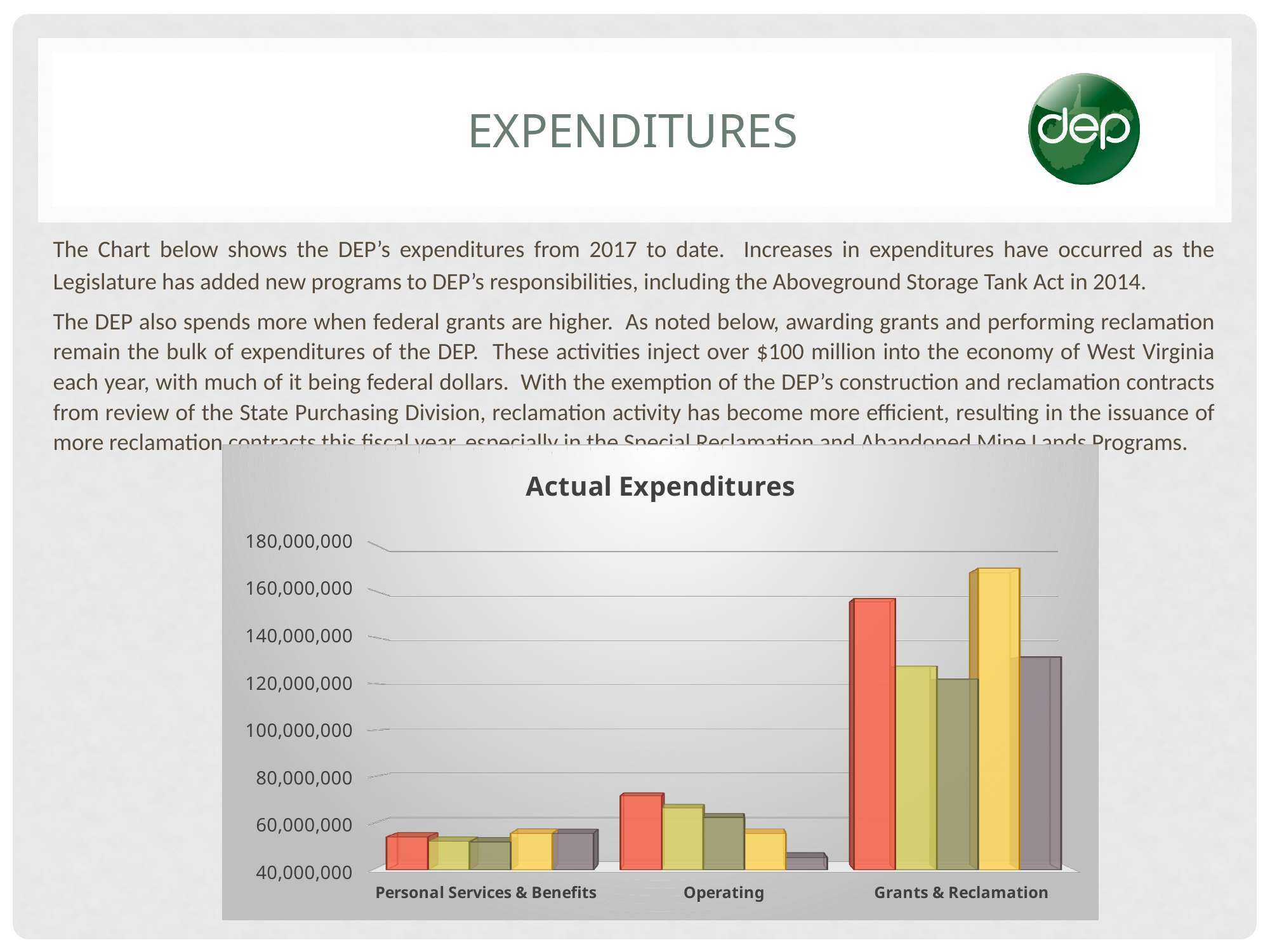
Which category has the highest expenditures in the chart? Grants & Reclamation Which category has the lowest expenditures in the chart? Personal Services & Benefits Is the value of the gray bar for Operating greater or less than 60,000,000? less For Grants & Reclamation, which is larger: the red bar or the yellow bar? the yellow bar Is the value of the tallest bar for Grants & Reclamation greater or less than 160,000,000? greater Is the value of the red bar for Grants & Reclamation greater or less than 140,000,000? greater What is the highest value shown on the chart's vertical axis? 180,000,000 How many bars are plotted for each category in the chart? 5 What is the title of the chart? Actual Expenditures What kind of chart is shown on the slide? bar chart How many categories are shown on the x axis of the chart? 3